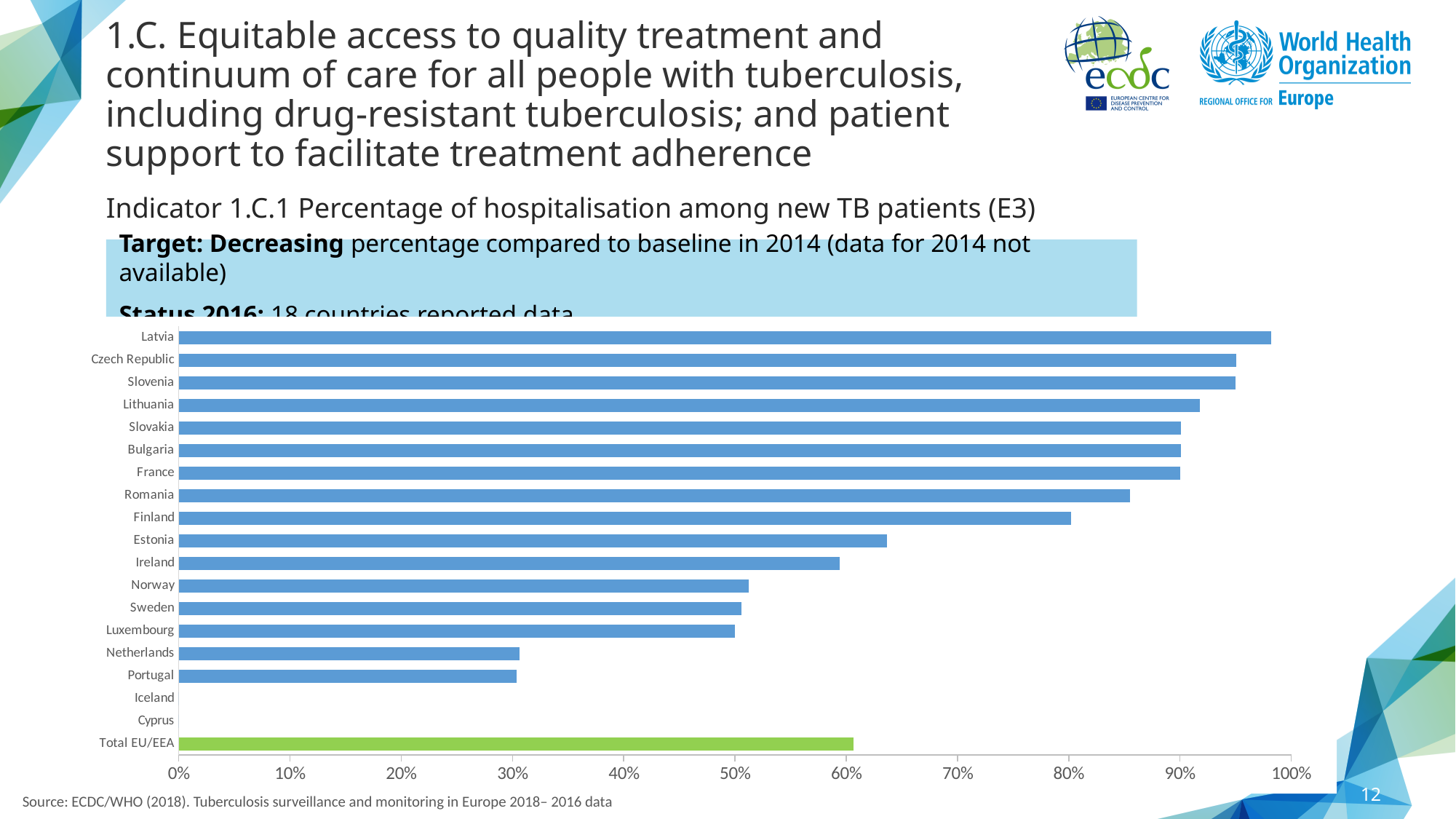
Which has a higher value, Finland or Estonia? Finland Is the value for Finland greater or less than 70%? greater Is the value for the Netherlands greater or less than 40%? less Is the value for Portugal greater or less than 40%? less Which country has the highest percentage of hospitalisation among new TB patients? Latvia Which bar in the chart is coloured green rather than blue? Total EU/EEA What kind of chart is shown on the slide? bar chart Which has a higher value, Romania or Ireland? Romania How many categories are listed on the vertical axis of the chart? 19